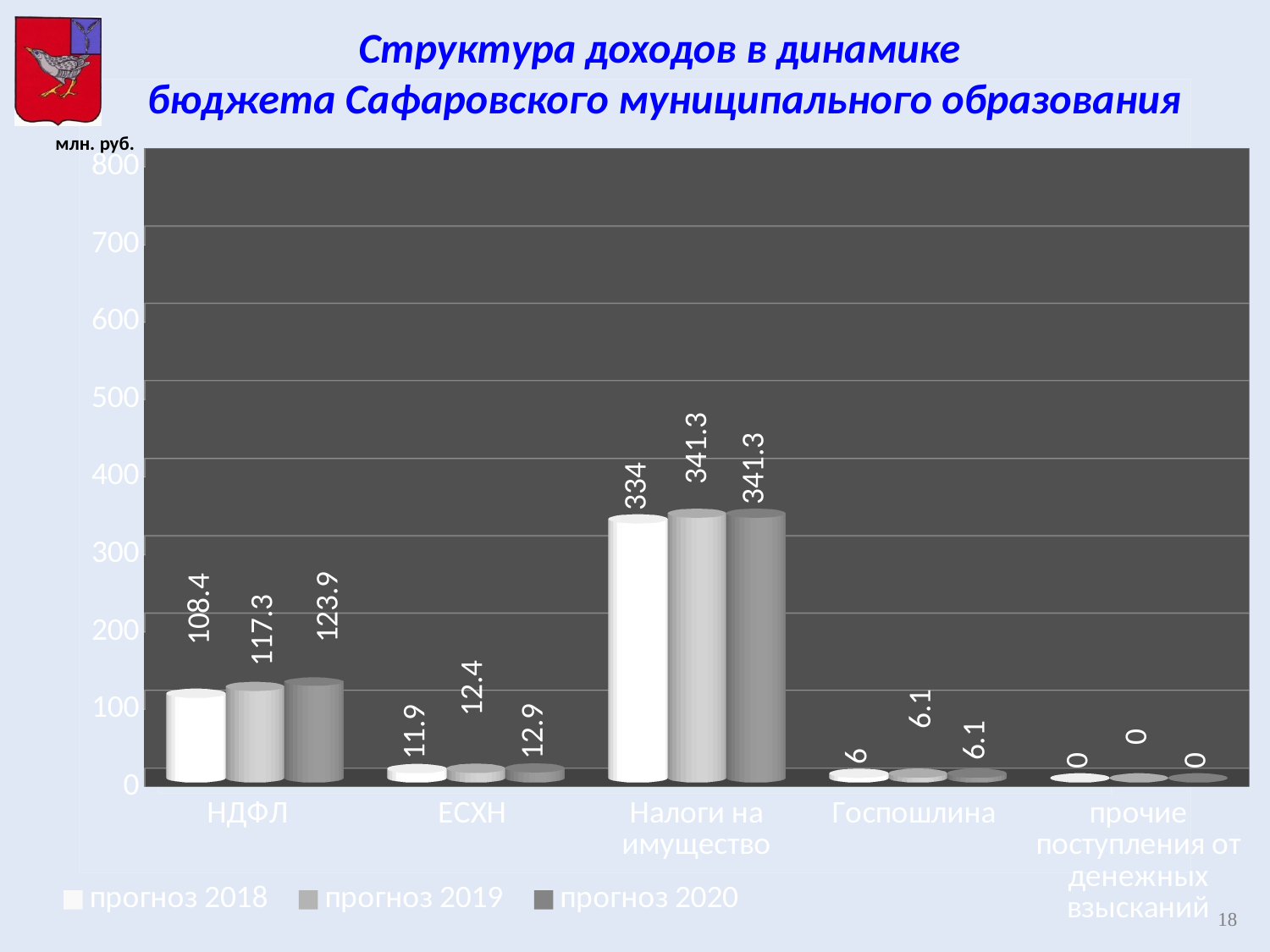
What is the value for Налоги на имущество in the прогноз 2018 series? 334 What unit is indicated above the vertical axis? млн. руб. How many series does the legend list? 3 Which category has the lowest value in the прогноз 2020 series? прочие поступления от денежных взысканий What is the difference between the прогноз 2020 and прогноз 2018 values for НДФЛ? 15.5 Which category has the highest value in the прогноз 2019 series? Налоги на имущество What is the value for Госпошлина in the прогноз 2018 series? 6 What is the value for НДФЛ in the прогноз 2020 series? 123.9 Which is larger for Налоги на имущество: the прогноз 2018 value or the прогноз 2019 value? прогноз 2019 What kind of chart is shown on the slide? bar chart What is the value for ЕСХН in the прогноз 2019 series? 12.4 How many categories are shown on the x axis? 5